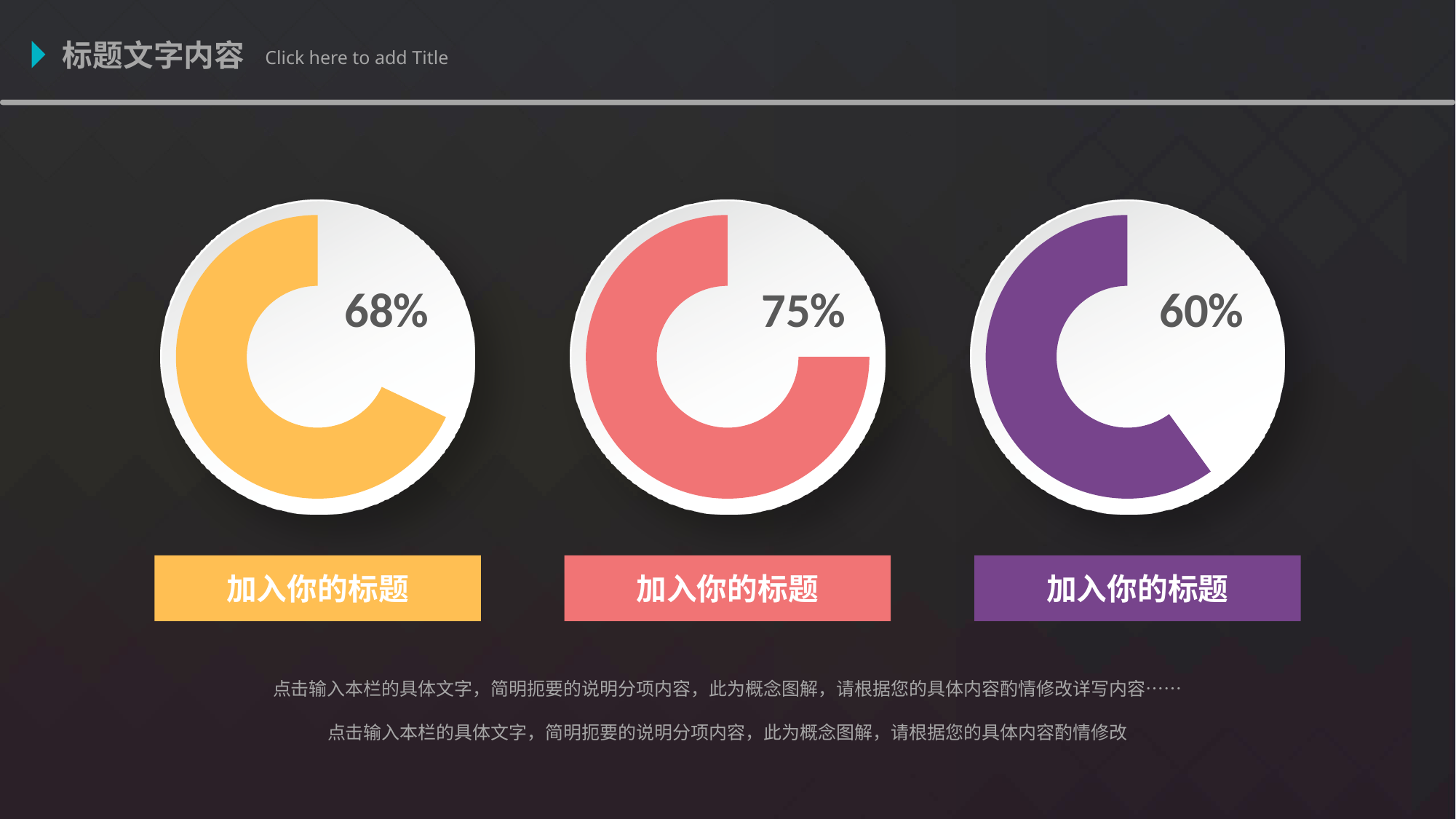
What value is shown in the right (purple) donut chart? 60% How many donut charts are shown on the slide? 3 What is the difference between the percentage in the middle (red) chart and the percentage in the right (purple) chart? 15% Which of the three donut charts shows the lowest percentage? The right (purple) chart, 60% What colour is the ring of the donut chart showing 75%? Red What is the difference between the percentage in the left (yellow) chart and the percentage in the right (purple) chart? 8% Which is larger, the value in the left (yellow) chart or the value in the middle (red) chart? The middle (red) chart What value is shown in the middle (red) donut chart? 75% Which of the three donut charts shows the highest percentage? The middle (red) chart, 75% What colour is the ring of the donut chart showing 60%? Purple What value is shown in the left (yellow) donut chart? 68% What kind of chart is used to display the percentages on the slide? Donut chart